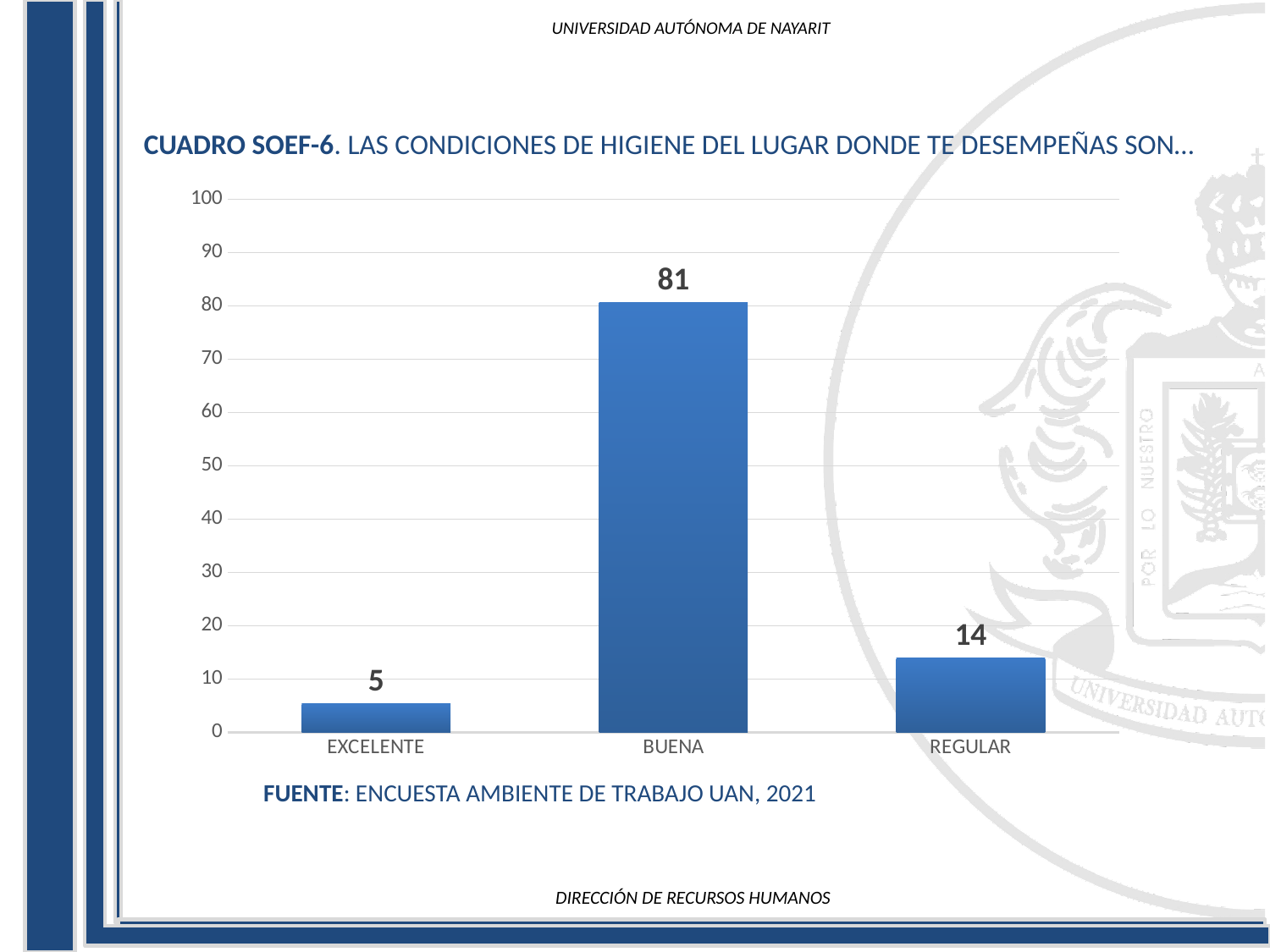
What is the difference between the values for REGULAR and EXCELENTE? 9 What is the value for BUENA? 81 Which is larger, the value for REGULAR or the value for EXCELENTE? REGULAR What kind of chart is shown on the slide? bar chart What is the value for REGULAR? 14 What is the value for EXCELENTE? 5 Is the value for BUENA greater or less than 50? greater Which category has the lowest value? EXCELENTE Which category has the highest value? BUENA What is the difference between the values for BUENA and REGULAR? 67 How many categories are shown on the x axis? 3 What is the source cited below the chart? ENCUESTA AMBIENTE DE TRABAJO UAN, 2021